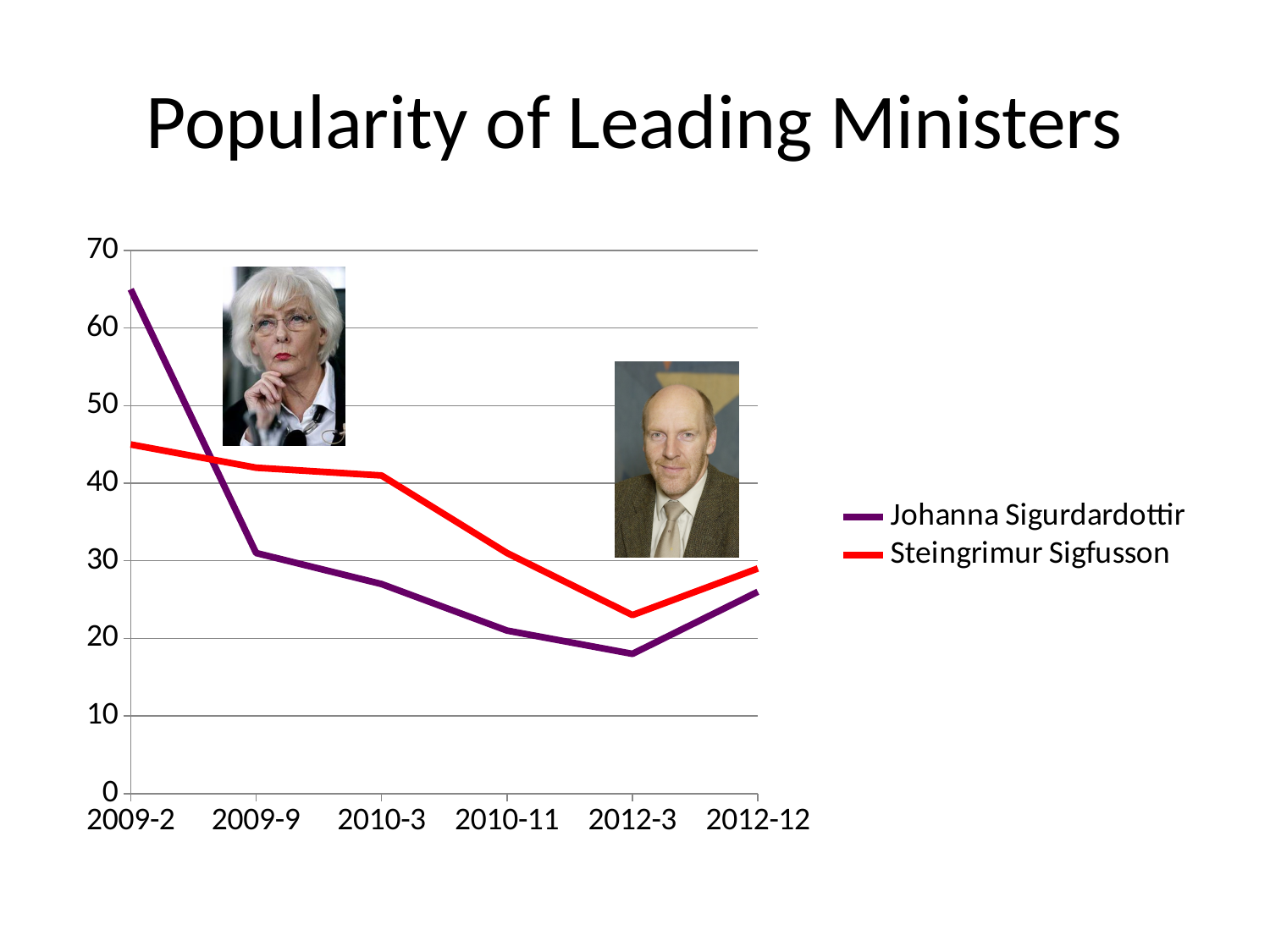
Which series is shown in purple? Johanna Sigurdardottir What kind of chart is shown on the slide? line chart Is the value for Johanna Sigurdardottir at 2009-2 greater or less than 60? greater Is the value for Johanna Sigurdardottir at 2010-11 greater or less than 30? less At 2012-3, which minister has the higher popularity, Johanna Sigurdardottir or Steingrimur Sigfusson? Steingrimur Sigfusson How many series does the legend list? 2 At which time point is Steingrimur Sigfusson's popularity lowest? 2012-3 Is the value for Steingrimur Sigfusson at 2009-2 greater or less than 50? less How many time points are shown on the x axis? 6 At which time point is Johanna Sigurdardottir's popularity highest? 2009-2 At 2009-2, which minister has the higher popularity, Johanna Sigurdardottir or Steingrimur Sigfusson? Johanna Sigurdardottir